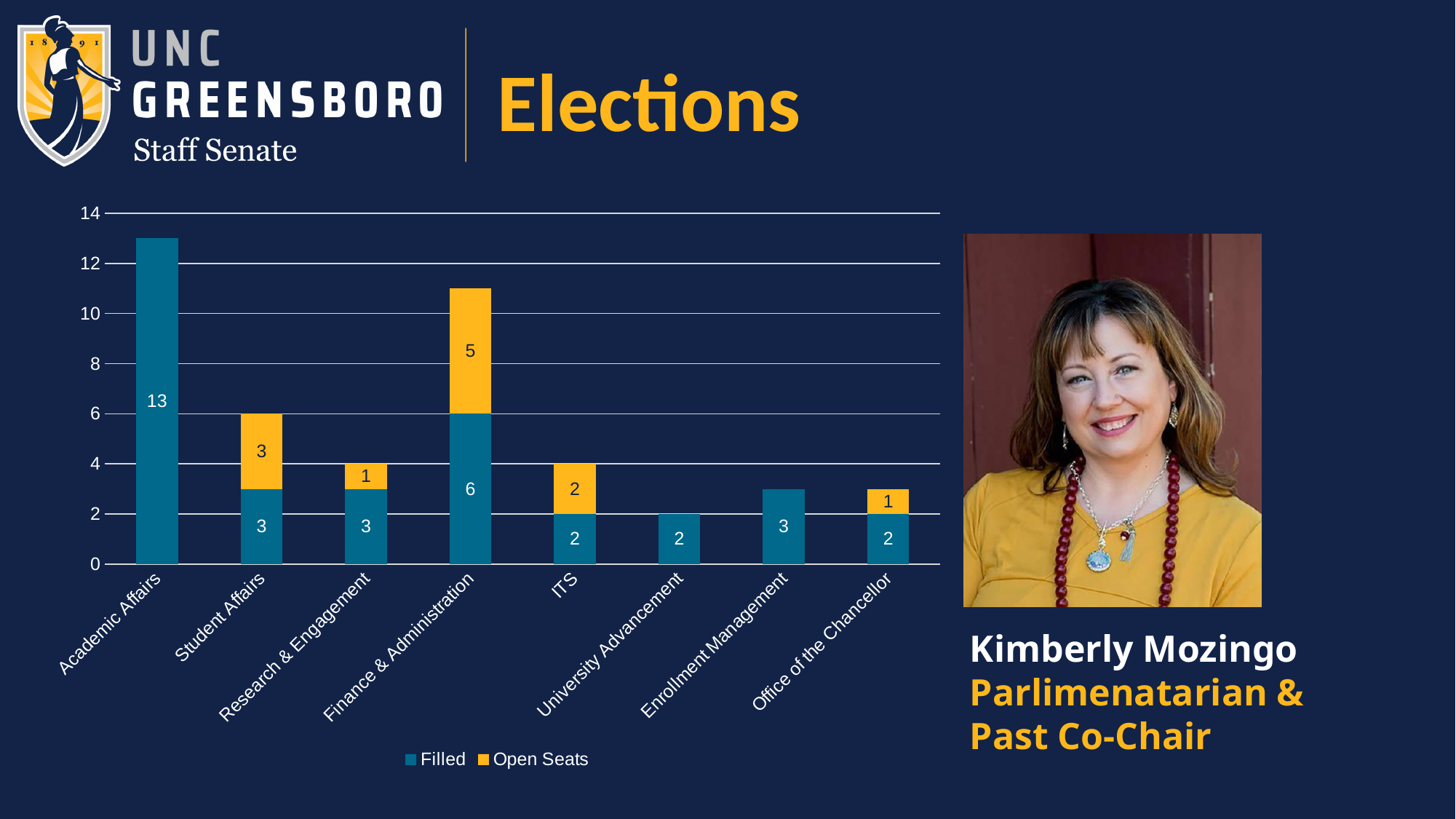
How many series does the legend list? 2 What is the difference between the Filled values for Academic Affairs and Finance & Administration? 7 What is the Open Seats value for Office of the Chancellor? 1 Which is larger, the Filled value for Enrollment Management or the Filled value for University Advancement? Enrollment Management What is the total of the stacked bar for Finance & Administration? 11 What is the Filled value for ITS? 2 What is the Open Seats value for Finance & Administration? 5 What is the Filled value for Academic Affairs? 13 How many categories are shown on the x axis? 8 What is the total of the stacked bar for Student Affairs? 6 Which category has the highest Open Seats value? Finance & Administration Which category has the highest Filled value? Academic Affairs